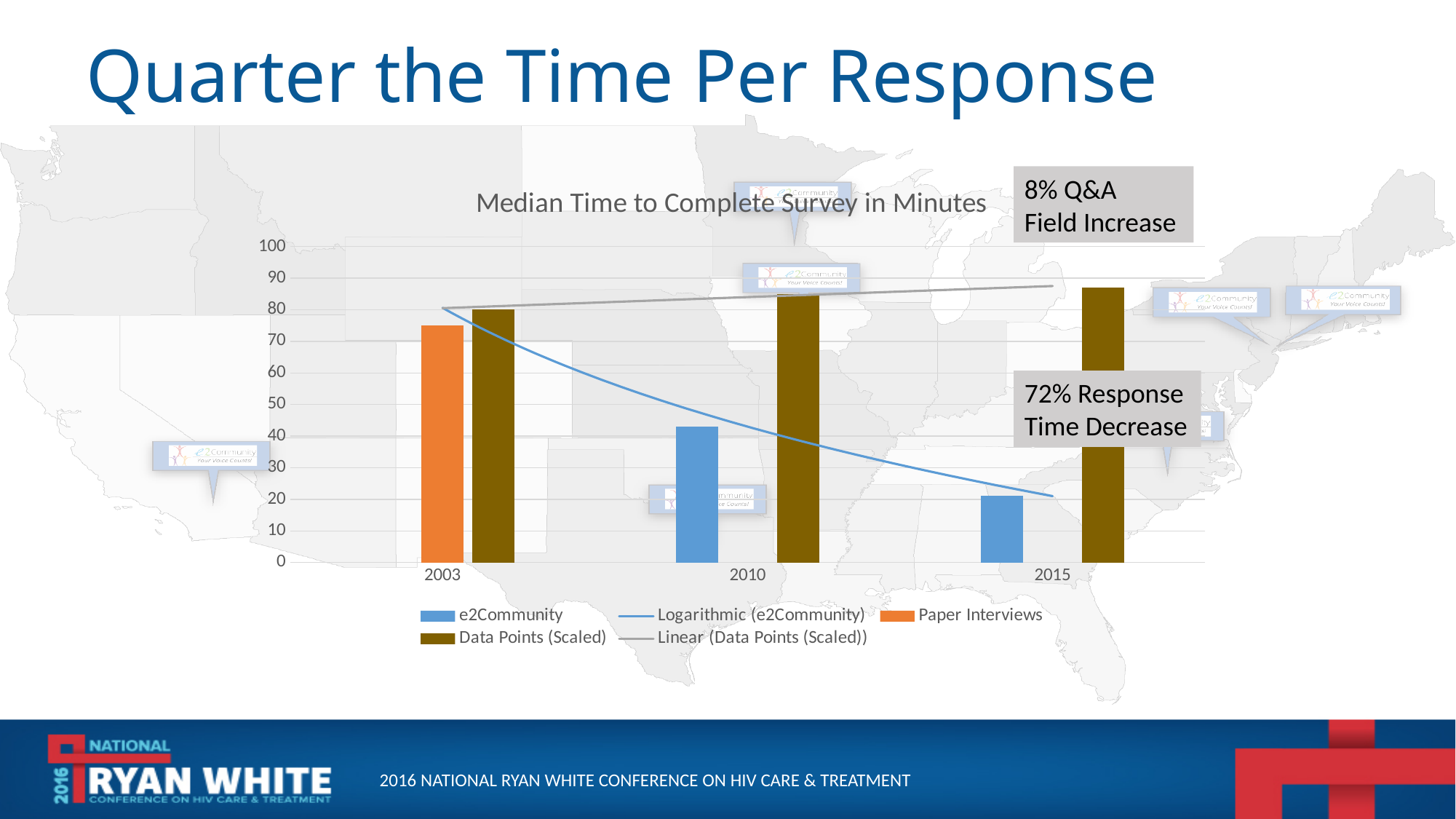
Is the e2Community value for 2010 greater or less than 50? less Is the Paper Interviews value for 2003 greater or less than 70? greater What is the title of the chart? Median Time to Complete Survey in Minutes How many entries does the chart's legend list? 5 How many years are shown on the x axis of the chart? 3 Do the e2Community values rise or fall from 2010 to 2015? Fall Is the Data Points (Scaled) value for 2015 greater or less than 80? greater What kind of chart is shown on the slide? Bar chart Which series has the highest bar in 2015? Data Points (Scaled) Which is larger, the e2Community value for 2010 or for 2015? 2010 What percentage response time decrease does the callout on the chart state? 72%